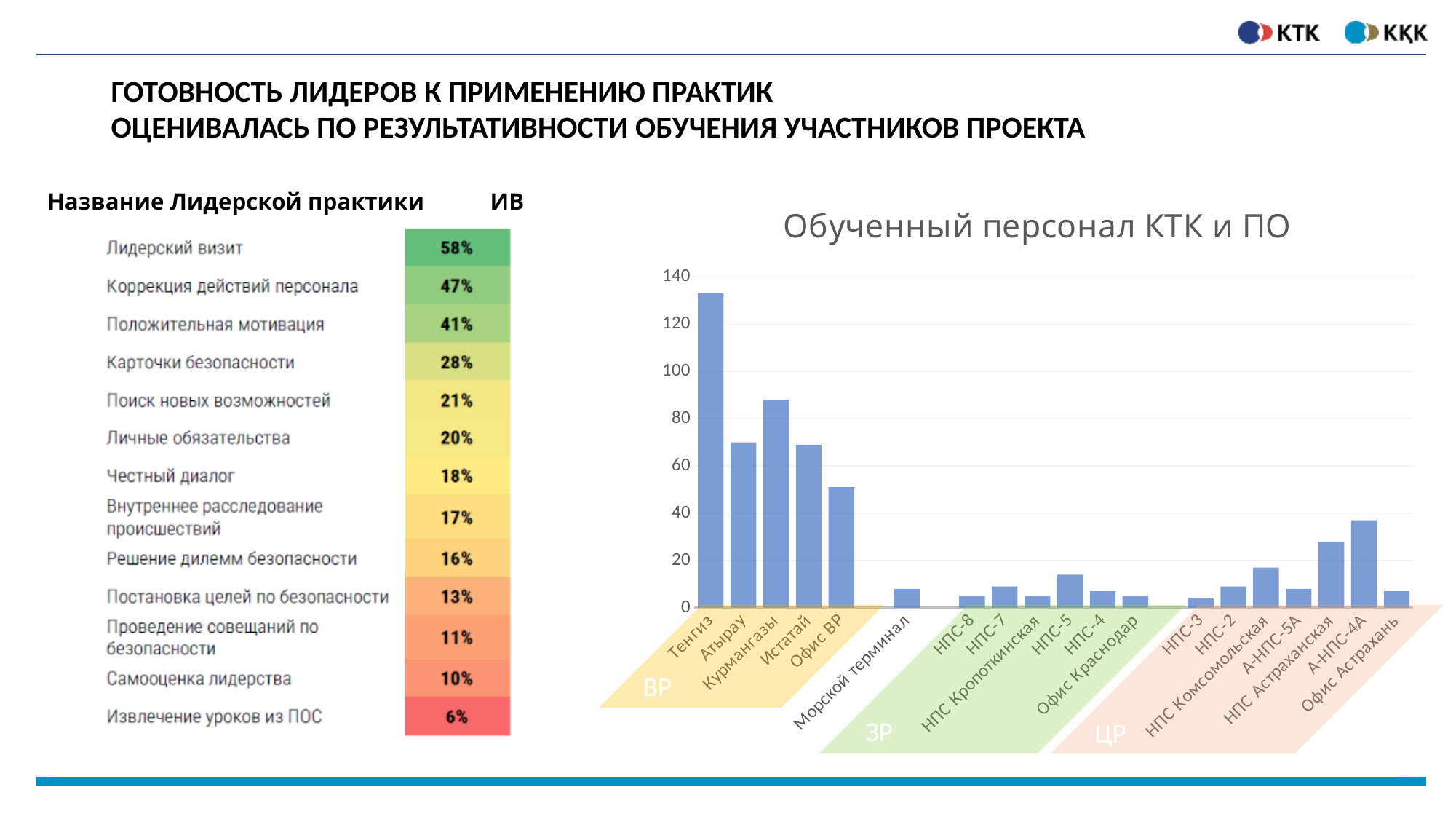
What is the title of the chart on the right side of the slide? Обученный персонал КТК и ПО In the chart "Обученный персонал КТК и ПО", which is larger, the value for А-НПС-4А or the value for НПС Астраханская? А-НПС-4А In the chart "Обученный персонал КТК и ПО", is the value for Тенгиз greater or less than 120? greater In the chart "Обученный персонал КТК и ПО", is the value for А-НПС-4А greater or less than 40? less In the chart "Обученный персонал КТК и ПО", is the value for Курмангазы greater or less than 80? greater What kind of chart is shown on the right side of the slide? bar chart In the chart "Обученный персонал КТК и ПО", how many categories are plotted along the x axis? 19 In the chart "Обученный персонал КТК и ПО", which is larger, the value for Курмангазы or the value for Атырау? Курмангазы In the chart "Обученный персонал КТК и ПО", what are the three region labels shown on the coloured bands below the x axis? ВР, ЗР, ЦР In the chart "Обученный персонал КТК и ПО", which category has the highest value? Тенгиз